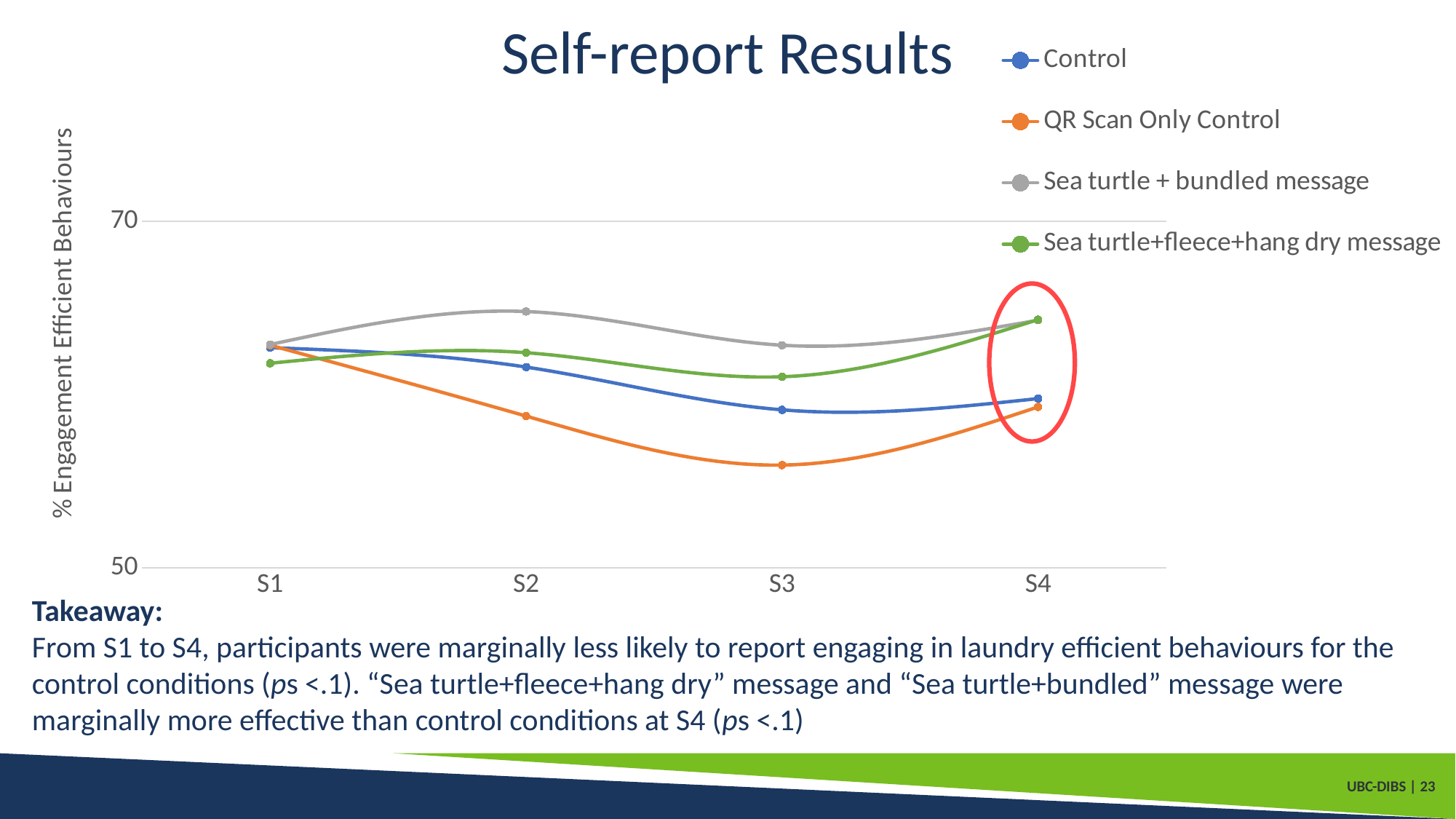
Which series has the lowest value at S3? QR Scan Only Control At S3, which is larger: Sea turtle+fleece+hang dry message or Control? Sea turtle+fleece+hang dry message Which series has the highest value at S3? Sea turtle + bundled message What is the title of the chart? Self-report Results Is the value for Sea turtle + bundled message at S2 greater or less than 50? greater How many time points are shown on the x axis? 4 Does the QR Scan Only Control series rise or fall from S1 to S3? fall Is the value for QR Scan Only Control at S3 greater or less than 70? less How many series does the legend list? 4 Which series has the highest value at S2? Sea turtle + bundled message What is the label on the y axis? % Engagement Efficient Behaviours What kind of chart is shown on the slide? line chart